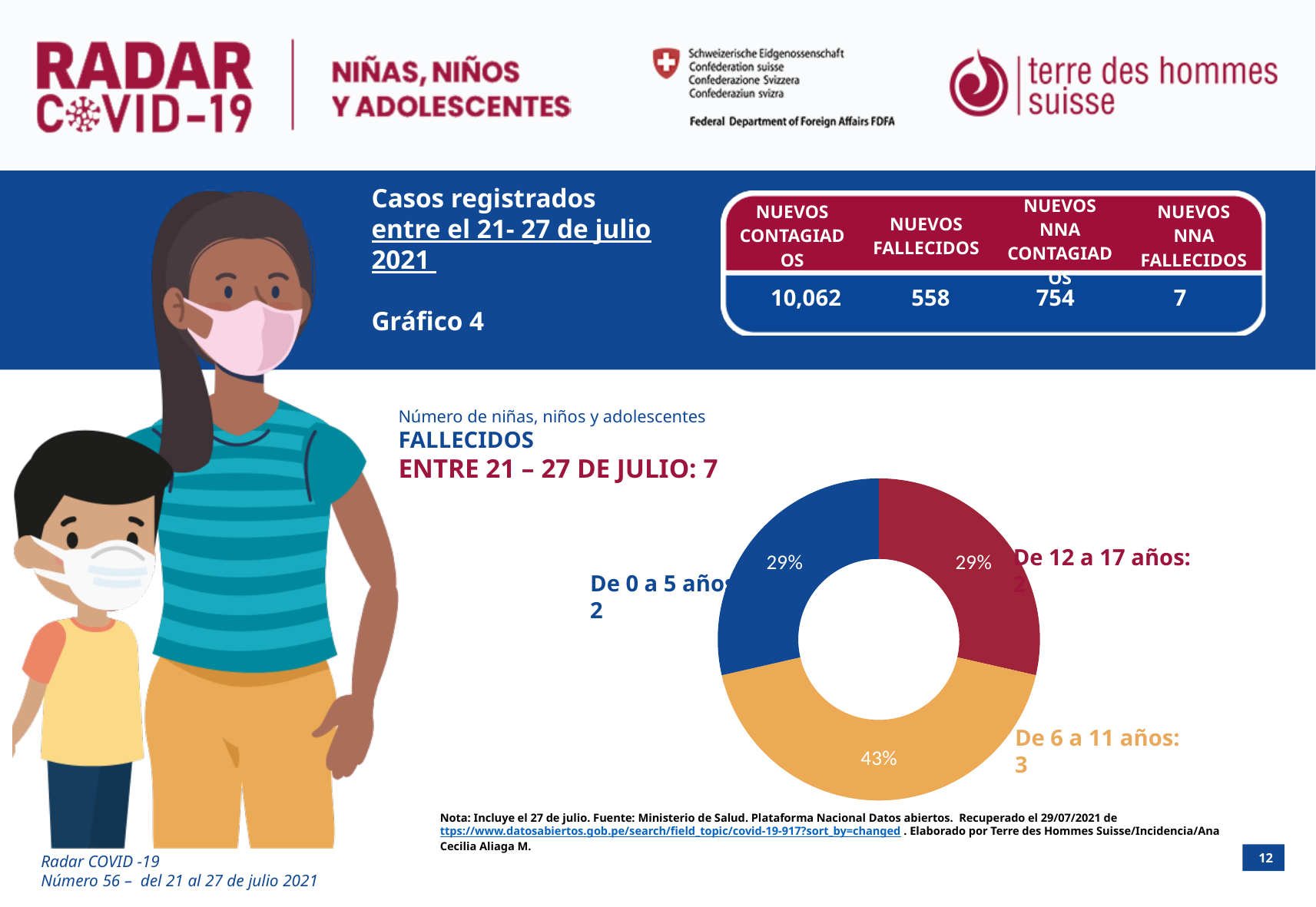
What kind of chart is shown on the slide? Donut (pie) chart Which is larger, the share for 'De 6 a 11 años' or the share for 'De 12 a 17 años'? De 6 a 11 años What percentage of the donut chart corresponds to 'De 6 a 11 años'? 43% What is the total number of deaths represented in the donut chart? 7 What percentage of the donut chart corresponds to 'De 0 a 5 años'? 29% How many deaths are shown for the 'De 0 a 5 años' group? 2 How many age-group categories does the donut chart show? 3 What colour is the slice for 'De 6 a 11 años' in the donut chart? Orange How many deaths are shown for the 'De 6 a 11 años' group? 3 What percentage of the donut chart corresponds to 'De 12 a 17 años'? 29% What is the difference in deaths between the 'De 6 a 11 años' group and the 'De 0 a 5 años' group? 1 Which age group has the largest share of the donut chart? De 6 a 11 años